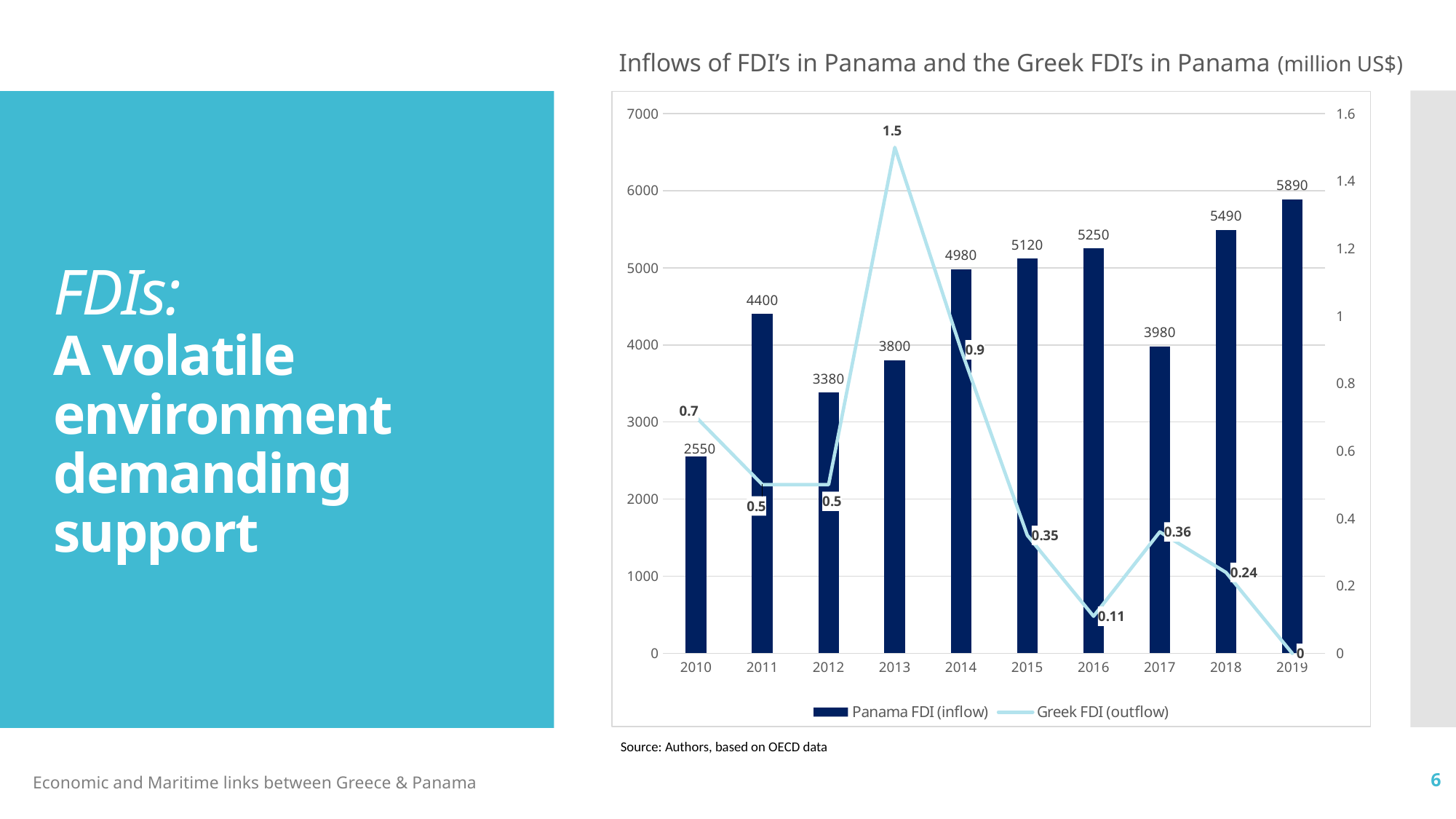
What kind of chart is used for the Panama FDI (inflow) series? Bar chart What is the Greek FDI (outflow) value for 2019? 0 What is the Panama FDI (inflow) value for 2013? 3800 Which year has the lowest Panama FDI (inflow)? 2010 What is the difference between the Panama FDI (inflow) in 2019 and in 2018? 400 Is the Panama FDI (inflow) for 2012 greater or less than 3000? greater How many years are shown on the x axis? 10 In which year does the Greek FDI (outflow) line reach its peak? 2013 Which is larger, the Panama FDI (inflow) in 2016 or in 2017? 2016 How many series does the legend list? 2 Which year has the highest Panama FDI (inflow)? 2019 What is the Greek FDI (outflow) value for 2014? 0.9